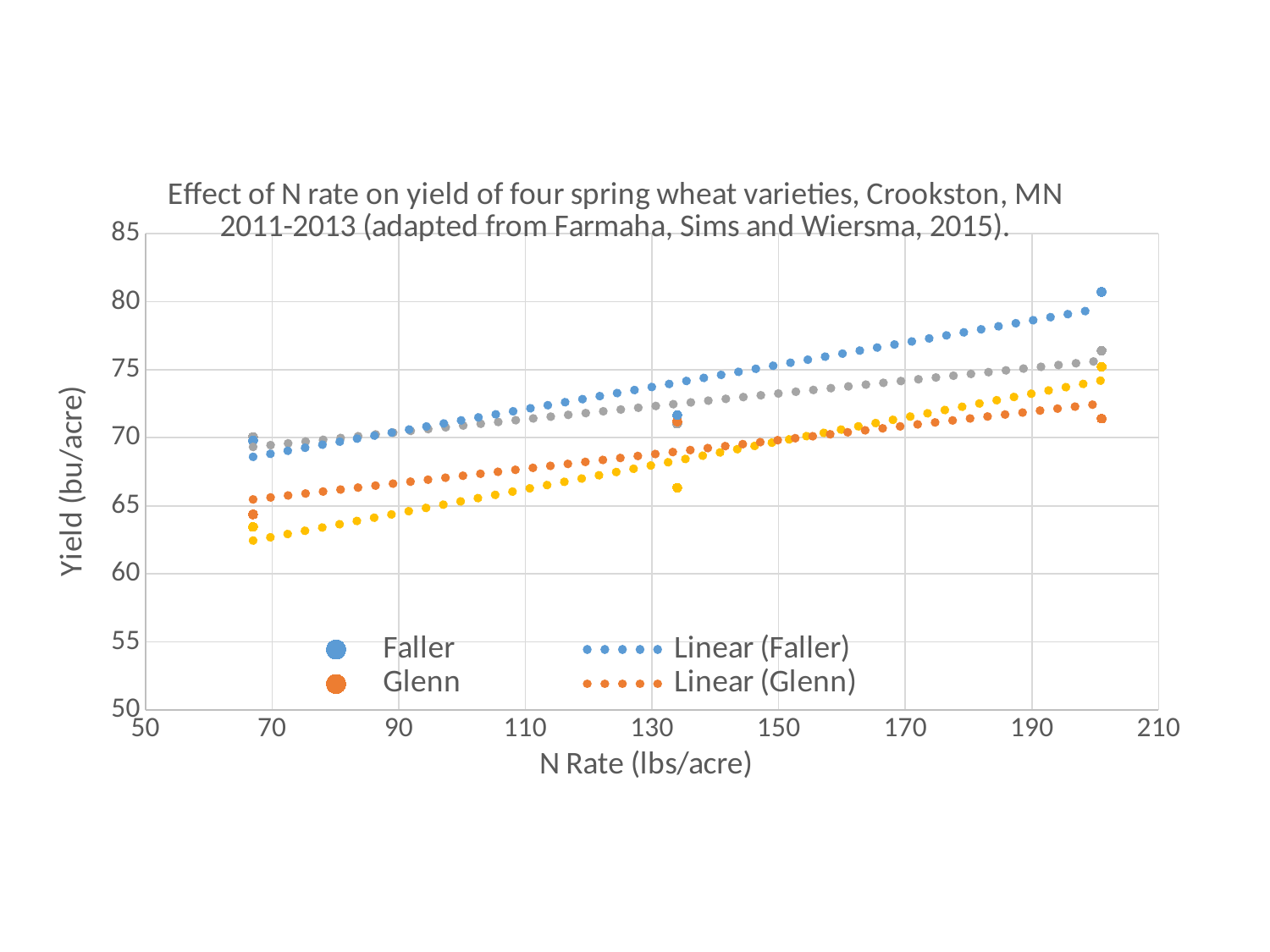
How many entries does the chart legend list? 4 What is the label of the y axis? Yield (bu/acre) Is the Faller yield at the highest N rate (about 200 lbs/acre) greater or less than 75? greater Does the Linear (Faller) trendline rise or fall as N rate increases? rise Is the Glenn yield at the highest N rate (about 200 lbs/acre) greater or less than 70? greater What is the title of the chart? Effect of N rate on yield of four spring wheat varieties, Crookston, MN 2011-2013 (adapted from Farmaha, Sims and Wiersma, 2015). At the highest N rate (about 200 lbs/acre), which variety has the higher yield, Faller or Glenn? Faller How many data points are plotted for the Faller series? 3 Does the Linear (Glenn) trendline rise or fall as N rate increases? rise What kind of chart is shown on the slide? scatter chart Is the Glenn yield at the lowest N rate (about 67 lbs/acre) greater or less than 70? less